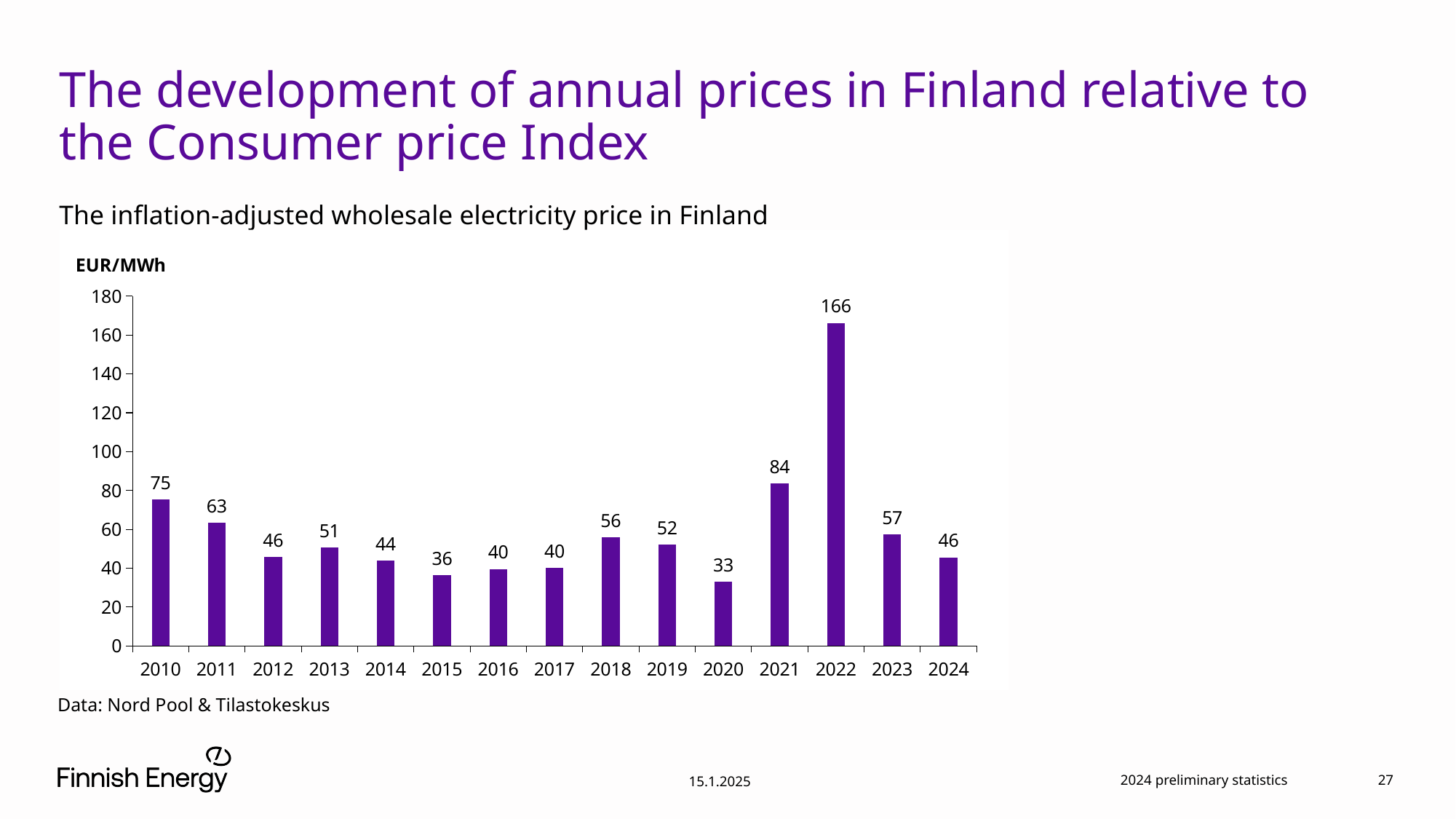
What is the value shown for 2010? 75 What kind of chart is shown on the slide? Bar chart What unit is shown on the y axis of the chart? EUR/MWh What is the difference between the values for 2022 and 2021? 82 Do the values rise or fall from 2022 to 2024? Fall Is the value for 2021 greater or less than 80? greater Which year has the lowest inflation-adjusted wholesale electricity price? 2020 How many years are shown on the x axis of the chart? 15 Which year has a larger value, 2018 or 2019? 2018 What is the value shown for 2020? 33 Which year has the highest inflation-adjusted wholesale electricity price? 2022 What is the inflation-adjusted wholesale electricity price in Finland for 2022? 166